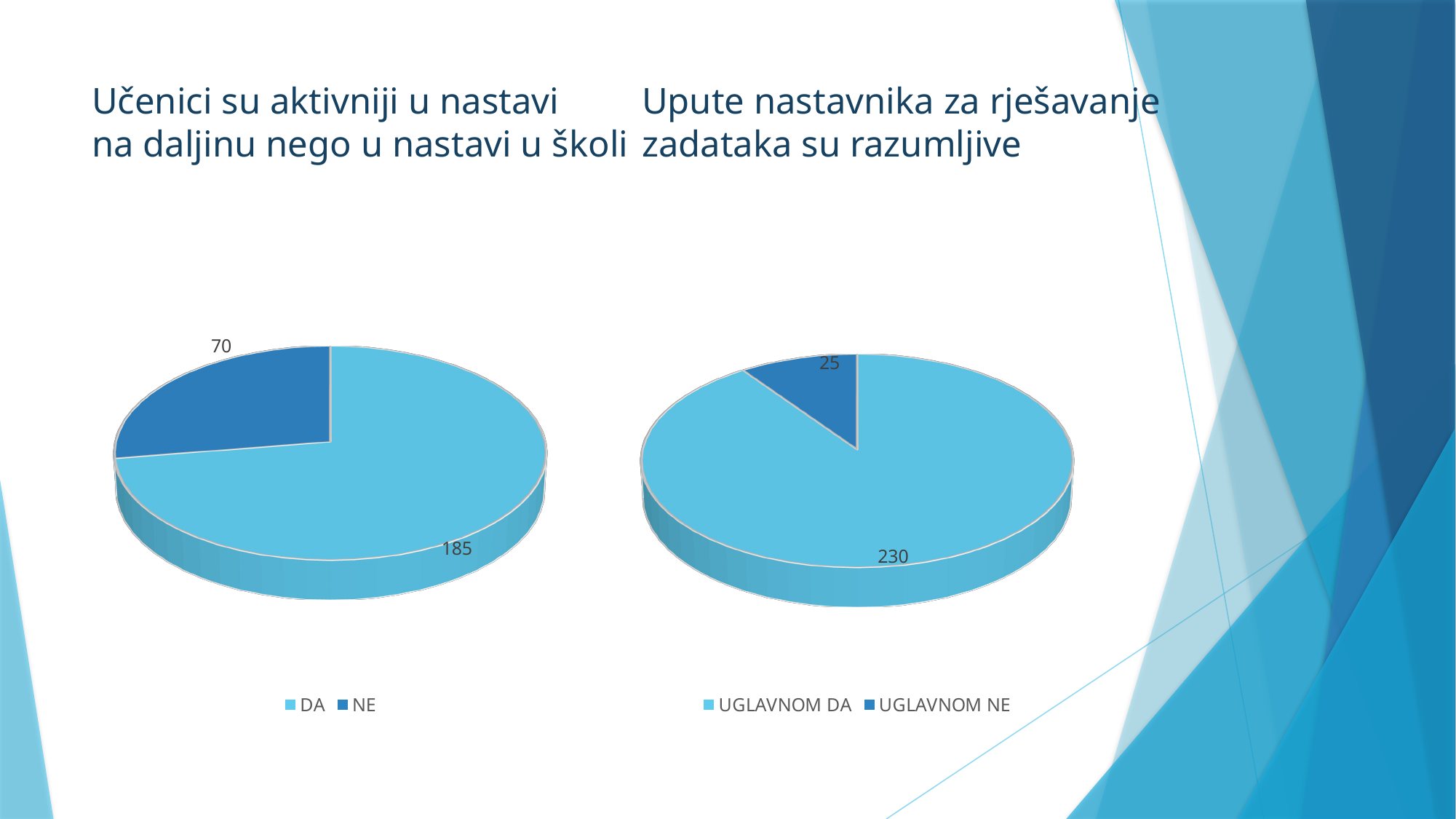
What type of chart is used on the left side of the slide? Pie chart In the right chart (Upute nastavnika za rješavanje zadataka su razumljive), what is the value for UGLAVNOM NE? 25 In the left chart, what is the difference between the DA and NE values? 115 In the left chart (Učenici su aktivniji u nastavi na daljinu nego u nastavi u školi), what is the value for DA? 185 How many categories does the legend of the right chart list? 2 In the right chart, what is the difference between the UGLAVNOM DA and UGLAVNOM NE values? 205 In the left chart (Učenici su aktivniji u nastavi na daljinu nego u nastavi u školi), what is the value for NE? 70 In the right chart, what is the total of all slices? 255 In the left chart, which category has the largest slice? DA In the right chart, which category has the smallest slice? UGLAVNOM NE In the right chart (Upute nastavnika za rješavanje zadataka su razumljive), what is the value for UGLAVNOM DA? 230 What is the title of the right chart? Upute nastavnika za rješavanje zadataka su razumljive